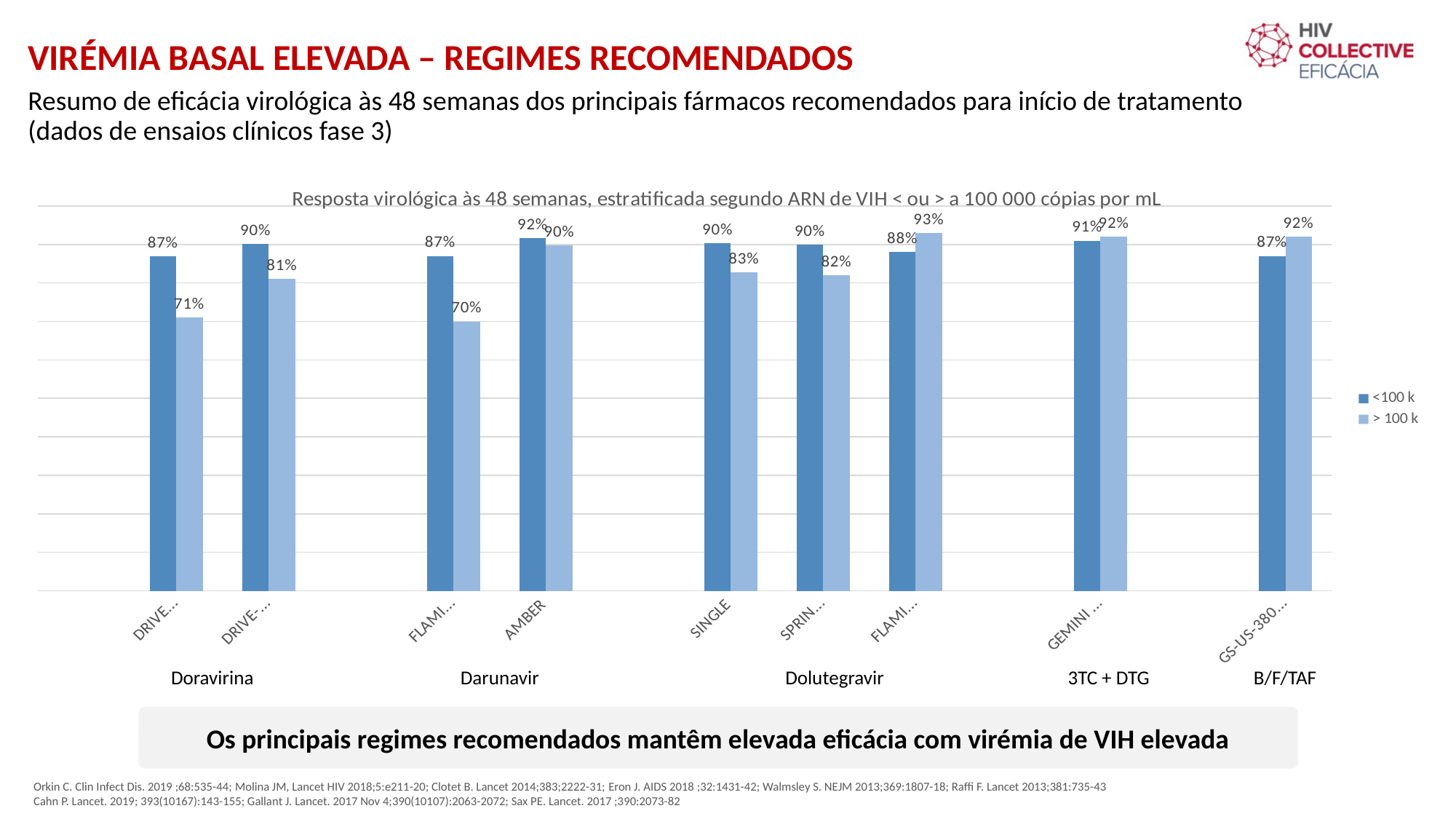
What is the value of the <100 k series for the B/F/TAF group? 87% How many trial categories (bar pairs) are plotted on the chart? 9 What type of chart is shown on the slide? Bar chart What is the value of the > 100 k series for the 3TC + DTG group? 92% What is the value of the <100 k series for AMBER? 92% Which is larger: the <100 k value for AMBER or the <100 k value for SINGLE? AMBER What is the difference between the <100 k and > 100 k values for SINGLE? 7 percentage points What is the value of the > 100 k series for SINGLE? 83% What is the lowest value shown in the > 100 k series? 70% What is the value of the > 100 k series for AMBER? 90% How many series does the chart legend list? 2 What is the highest value shown in the > 100 k series? 93%